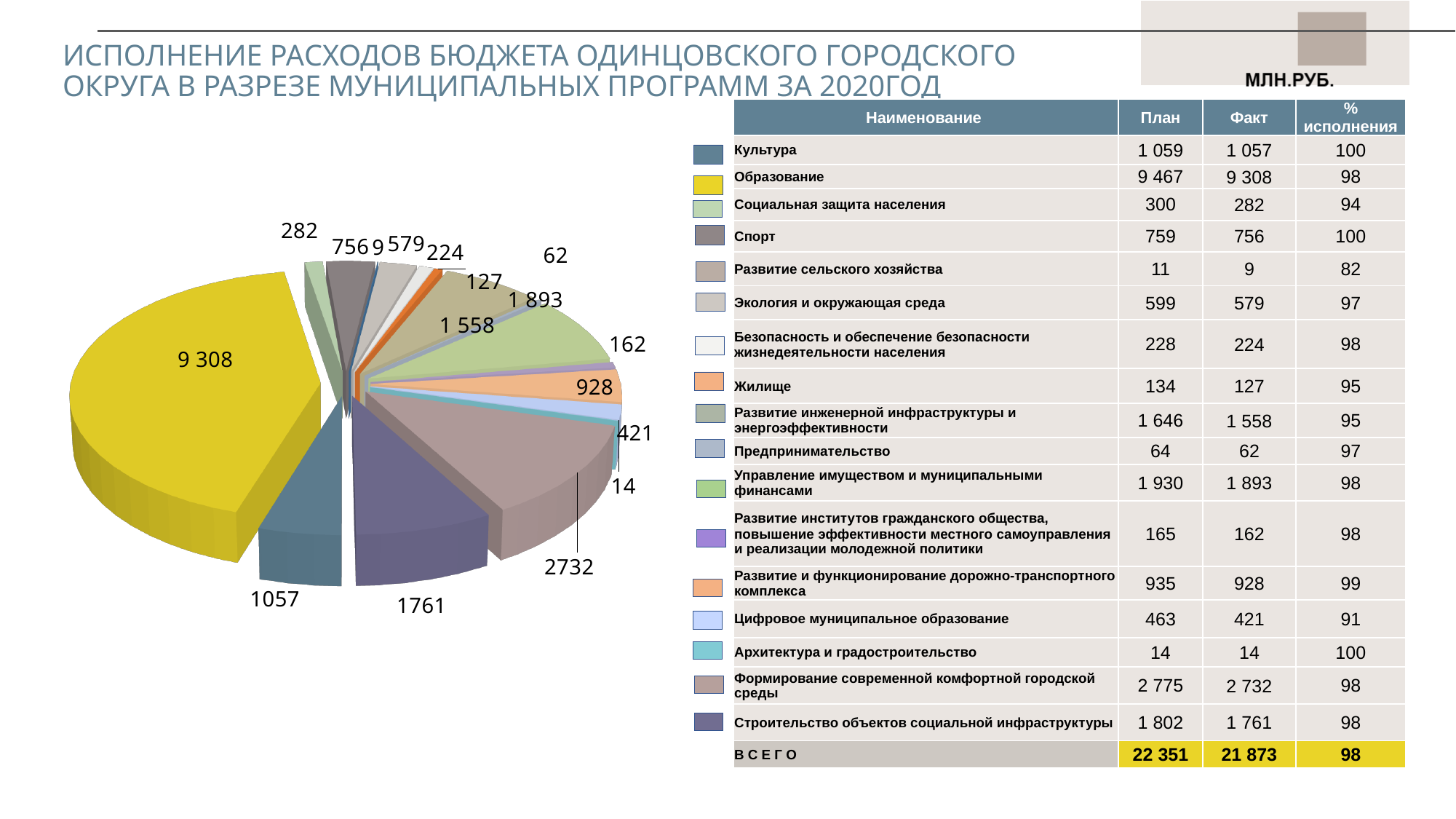
Which category has the largest slice of the pie? Образование What value is labelled on the pie slice for Архитектура и градостроительство? 14 What value is labelled on the pie slice for Образование? 9 308 Which slice is larger: Управление имуществом и муниципальными финансами or Развитие инженерной инфраструктуры и энергоэффективности? Управление имуществом и муниципальными финансами What colour is the slice for Образование? yellow What value is labelled on the pie slice for Формирование современной комфортной городской среды? 2732 What is the difference between the pie values for Формирование современной комфортной городской среды (2732) and Строительство объектов социальной инфраструктуры (1761)? 971 What value is labelled on the pie slice for Строительство объектов социальной инфраструктуры? 1761 What value is labelled on the pie slice for Культура? 1057 Which category has the smallest slice of the pie? Развитие сельского хозяйства What type of chart is shown on the slide? pie chart